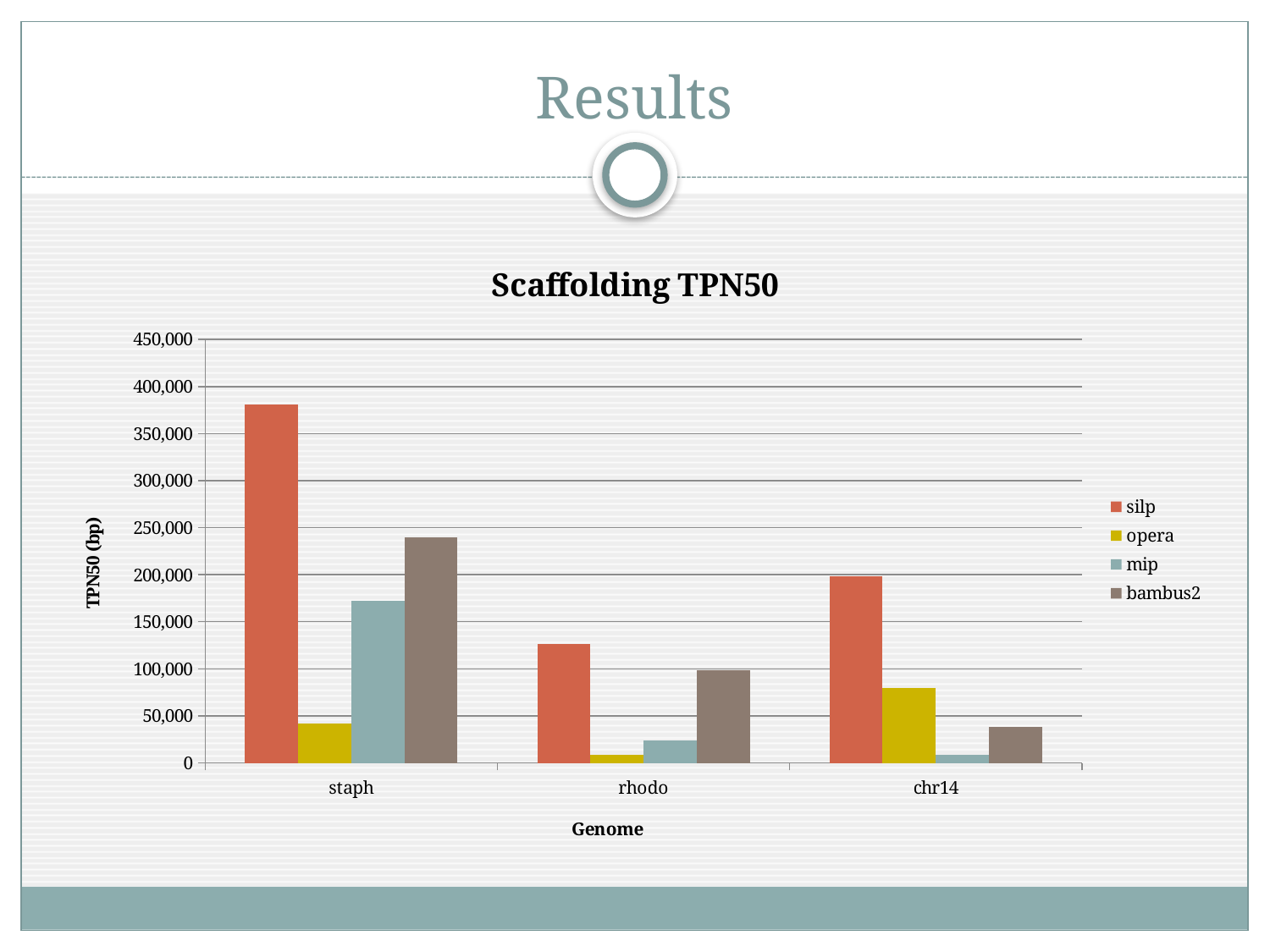
What type of chart is shown on the slide? bar chart Which is larger for chr14, opera or mip? opera Which series has the highest value for staph? silp For which genome does silp have its highest value? staph Which is larger for staph, mip or bambus2? bambus2 What is the title of the chart? Scaffolding TPN50 How many series does the legend list? 4 How many genomes are shown on the x axis? 3 Is the value for silp at staph greater or less than 350,000? greater What is the label of the y axis? TPN50 (bp) Is the value for mip at staph greater or less than 150,000? greater Which series has the lowest value for rhodo? opera